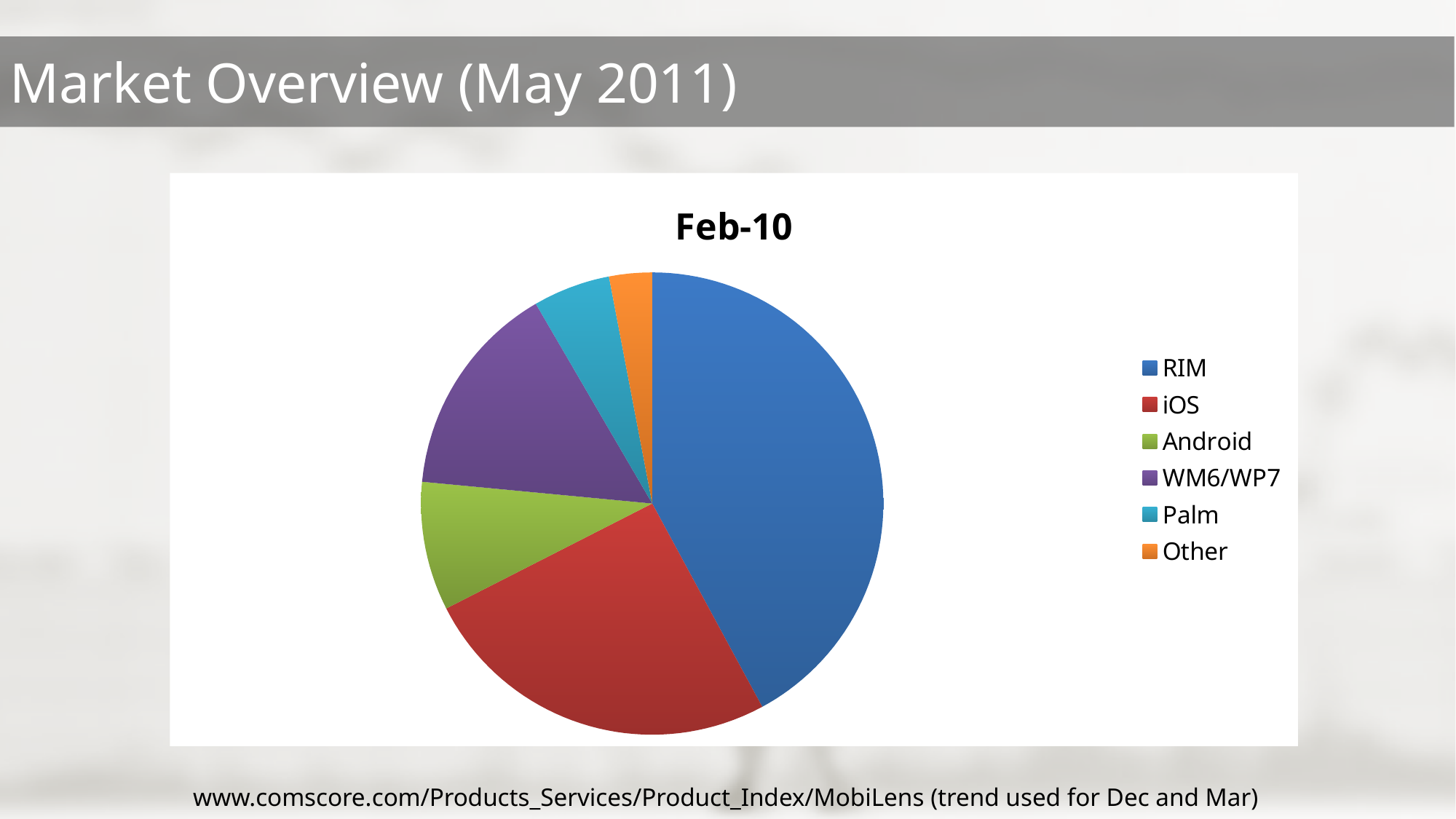
What colour is the slice for Palm? Light blue Which slice is larger, Android or Palm? Android How many slices does the pie chart have? 6 Which slice is larger, RIM or iOS? RIM Which slice is larger, Android or WM6/WP7? WM6/WP7 What kind of chart is shown on the slide? Pie chart Which category has the smallest slice of the pie? Other Which category has the largest slice of the pie? RIM How many categories does the legend of the pie chart list? 6 What is the title of the chart? Feb-10 Which category has the second-largest slice of the pie? iOS